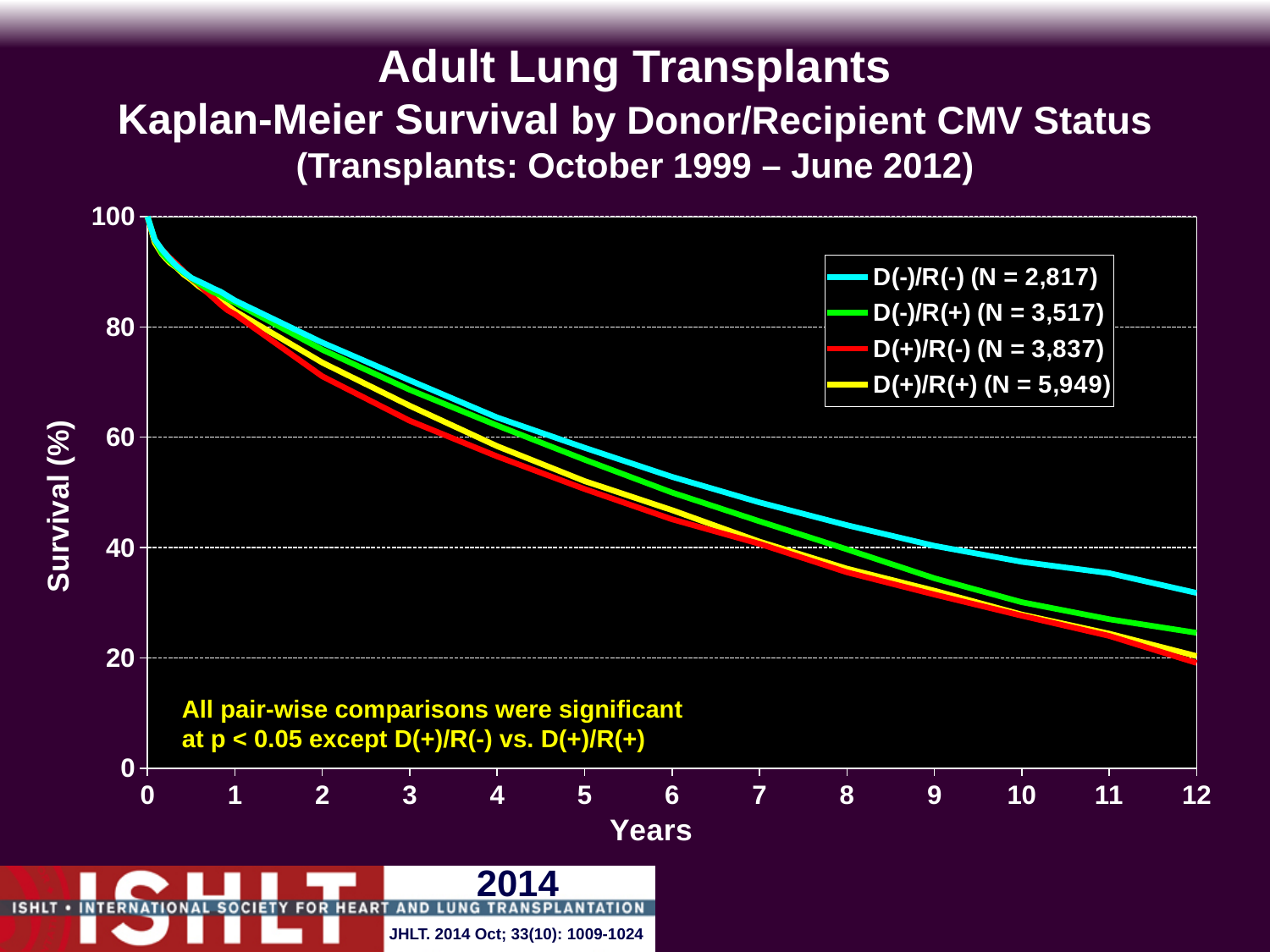
Is the survival value for D(+)/R(-) at 6 years greater or less than 60? less Which group has the largest N in the legend? D(+)/R(+) Which group has the smallest N in the legend? D(-)/R(-) What is the N for the D(-)/R(-) group shown in the legend? 2,817 What is the label of the y axis? Survival (%) Is the survival value for D(-)/R(-) at 12 years greater or less than 20? greater What is the difference between the N for D(+)/R(+) and the N for D(-)/R(-)? 3,132 At 12 years, which group has higher survival: D(-)/R(-) or D(+)/R(-)? D(-)/R(-) What is the N for the D(+)/R(+) group shown in the legend? 5,949 Do the survival curves rise or fall as years increase? Fall What kind of chart is shown on the slide? Line chart How many series does the legend list? 4